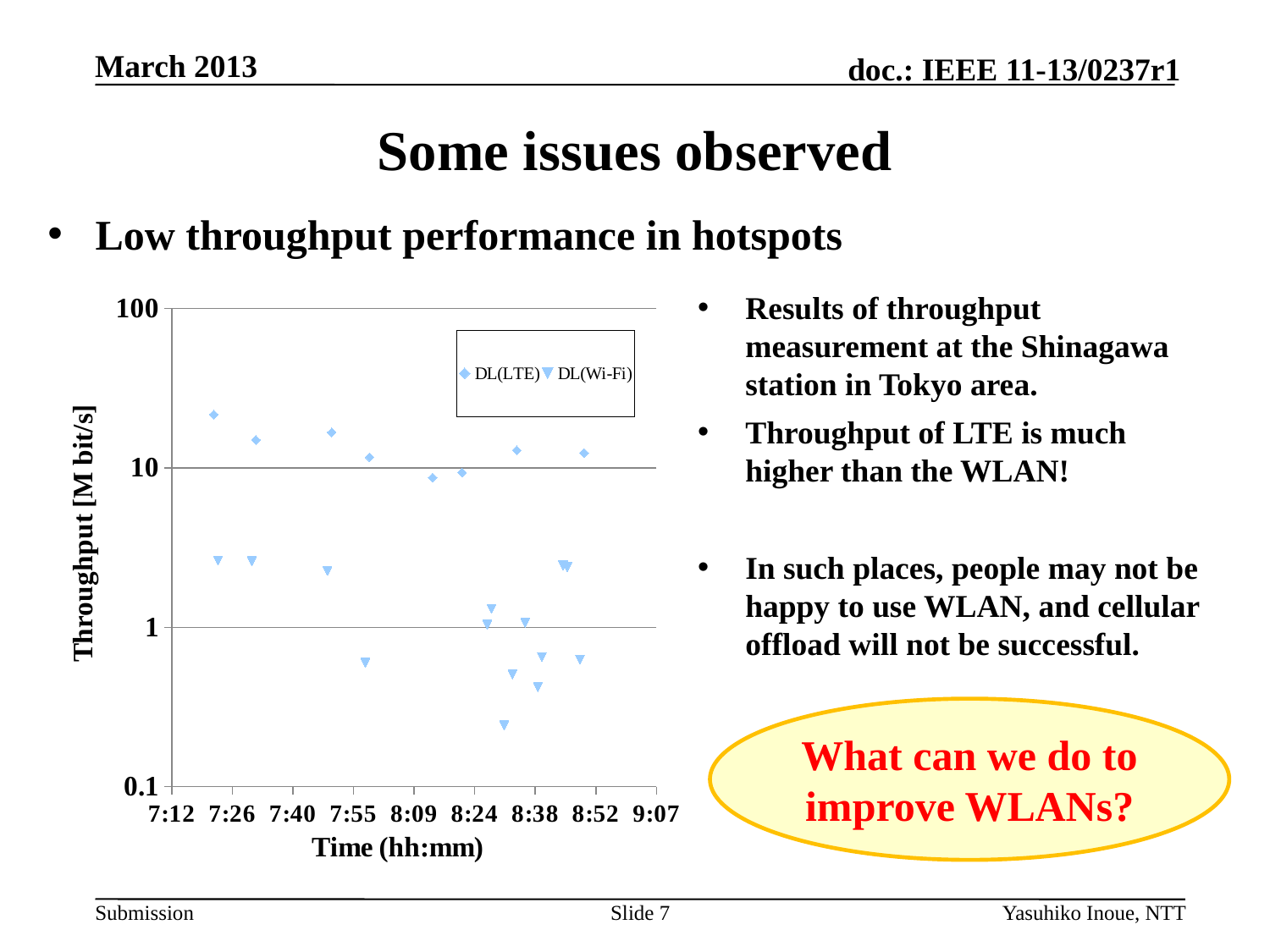
Is the DL(Wi-Fi) value at around 7:59 greater or less than 1? less Are all DL(LTE) values on the chart greater or less than 1? greater What are the two series named in the chart legend? DL(LTE) and DL(Wi-Fi) How many series does the chart legend list? 2 Which series has higher throughput values overall, DL(LTE) or DL(Wi-Fi)? DL(LTE) Is the DL(Wi-Fi) value at the earliest measurement time (around 7:23) greater or less than 10? less What is the label of the vertical axis of the chart? Throughput [M bit/s] What kind of chart is shown on the slide? scatter chart